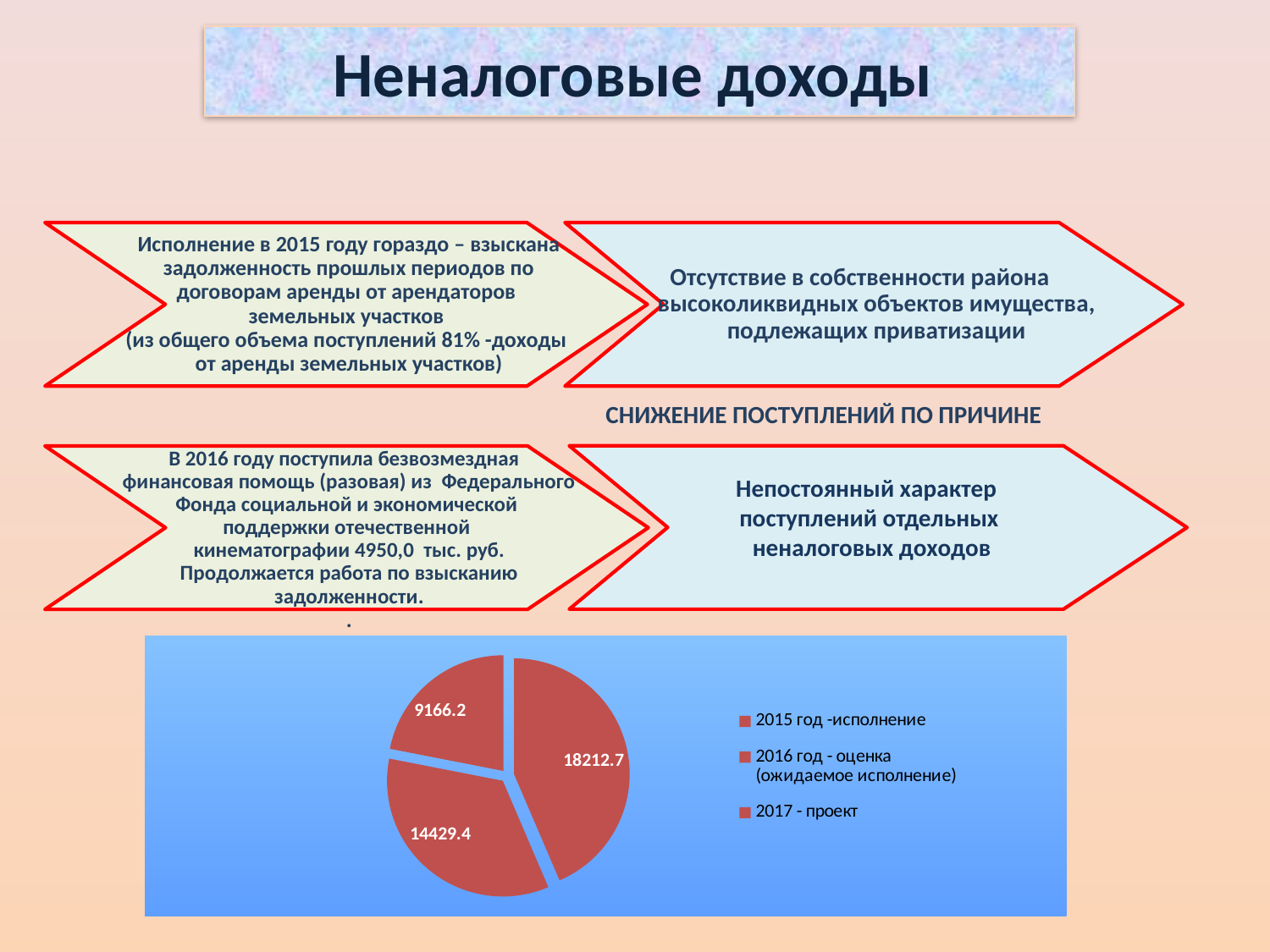
How many slices does the pie chart have? 3 How many entries does the legend of the pie chart list? 3 What is the value of the largest slice in the pie chart? 18212.7 What is the first entry listed in the legend of the pie chart? 2015 год -исполнение Which slice is larger in the pie chart: the one labelled 14429.4 or the one labelled 9166.2? 14429.4 What is the difference between the slices labelled 18212.7 and 14429.4 in the pie chart? 3783.3 What is the last entry listed in the legend of the pie chart? 2017 - проект What is the total of all three slice values in the pie chart? 41808.3 What kind of chart is shown at the bottom of the slide? pie chart What is the difference between the largest slice (18212.7) and the smallest slice (9166.2) in the pie chart? 9046.5 What is the value of the smallest slice in the pie chart? 9166.2